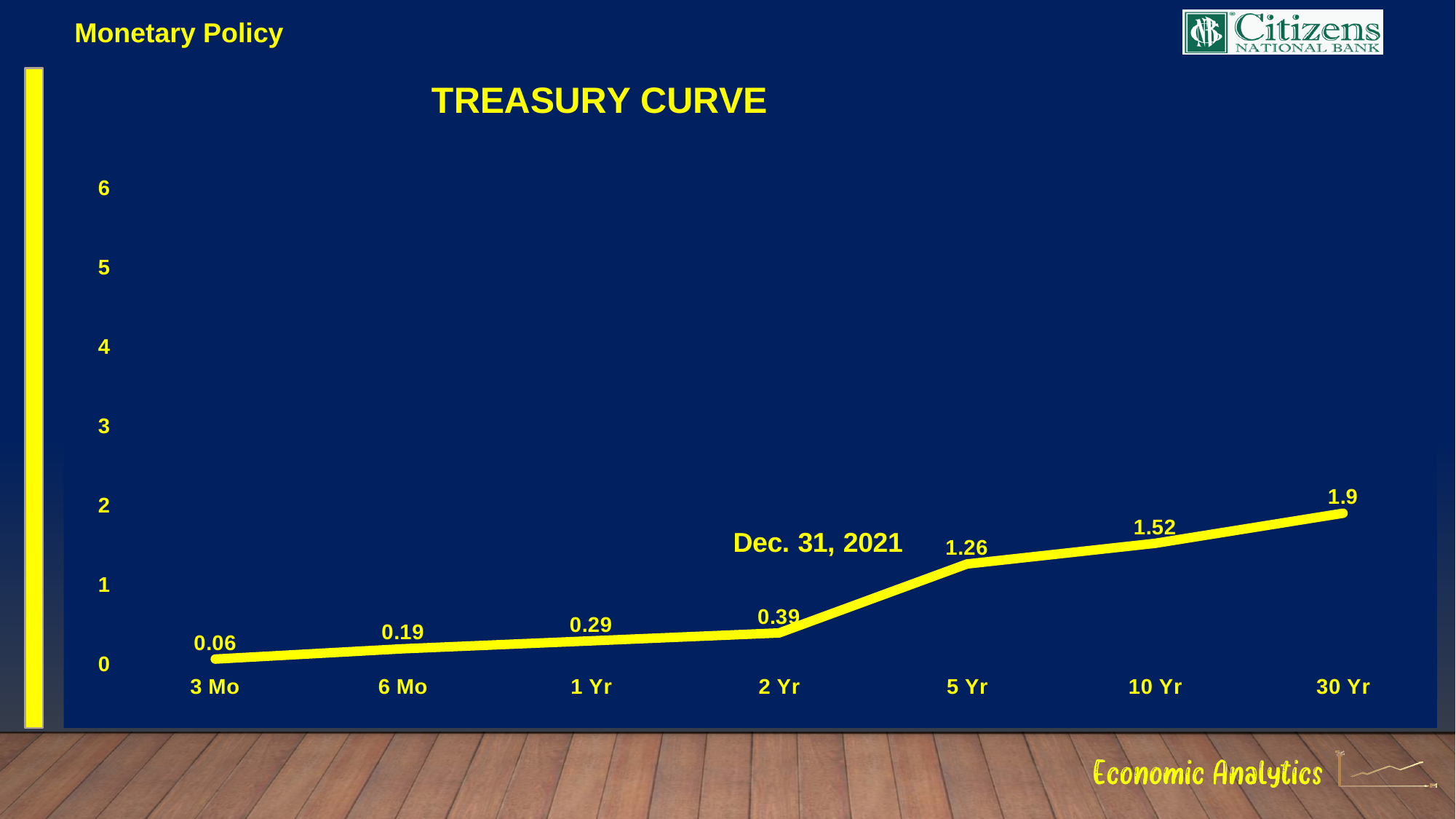
What is the difference between the 10 Yr and 5 Yr values on the Treasury Curve chart? 0.26 How many maturities are plotted on the Treasury Curve chart? 7 What is the value for 2 Yr on the Treasury Curve chart? 0.39 What is the value for 5 Yr on the Treasury Curve chart? 1.26 Is the value for 30 Yr on the Treasury Curve chart greater or less than 2? less Which maturity has the lowest value on the Treasury Curve chart? 3 Mo Which is larger on the Treasury Curve chart, the 1 Yr value or the 6 Mo value? 1 Yr Which maturity has the highest value on the Treasury Curve chart? 30 Yr What is the value for 30 Yr on the Treasury Curve chart? 1.9 What is the value for 3 Mo on the Treasury Curve chart? 0.06 Do the values on the Treasury Curve chart rise or fall from 3 Mo to 30 Yr? rise What kind of chart is the Treasury Curve chart? line chart